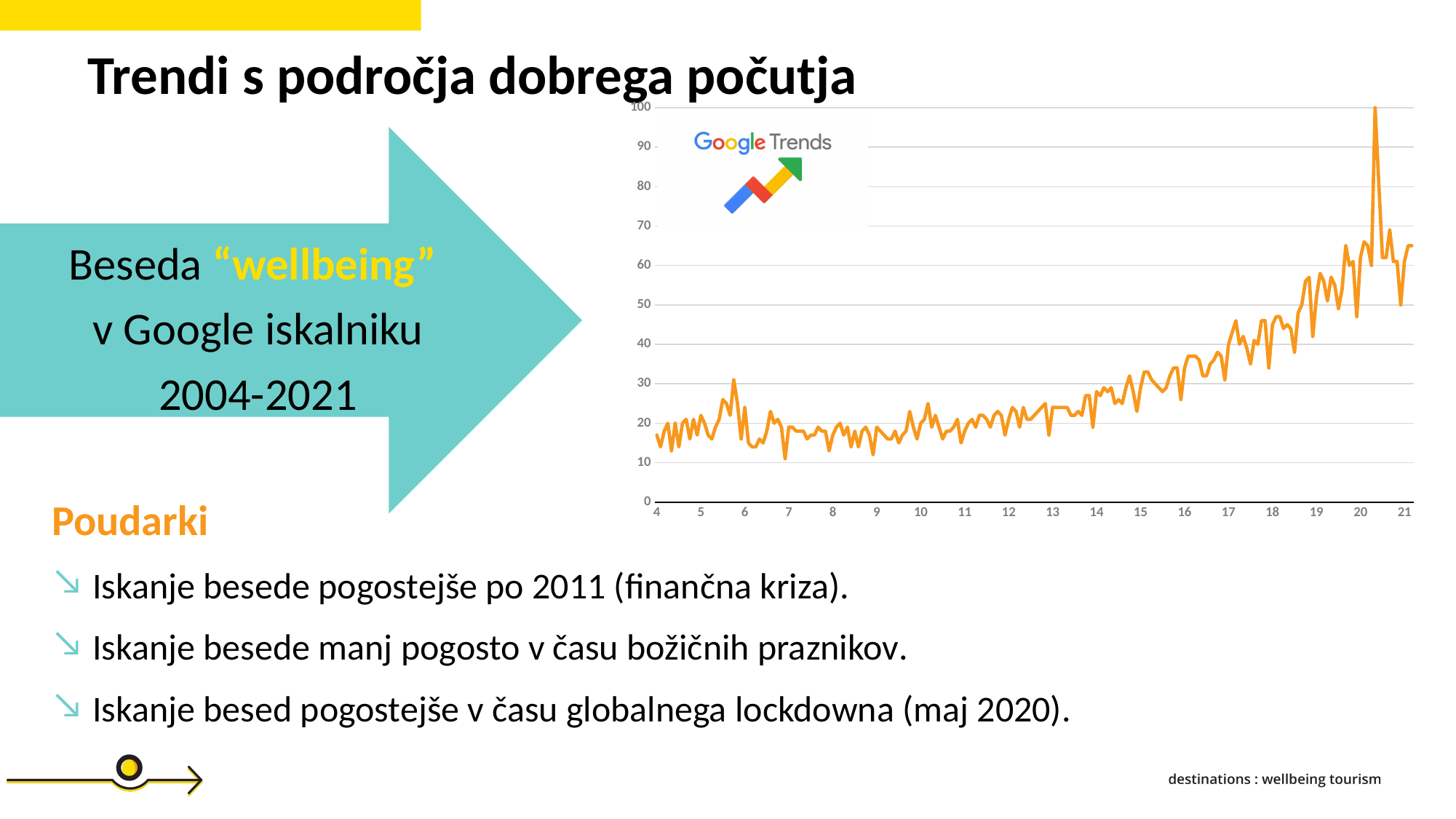
Is the value of the line at x-axis label 7 greater or less than 30? less Near which x-axis label does the line reach its highest point? 20 Is the value of the line at x-axis label 17 greater or less than 20? greater Is the value of the line at x-axis label 21 greater or less than 40? greater Which has the larger value on the line: x-axis label 4 or x-axis label 21? 21 How many labels are shown on the x axis of the chart? 18 What colour is the line in the chart? orange Overall, do the values in the chart rise or fall from left to right along the x axis? rise What is the highest tick value shown on the y axis? 100 What kind of chart is shown on the slide? line chart